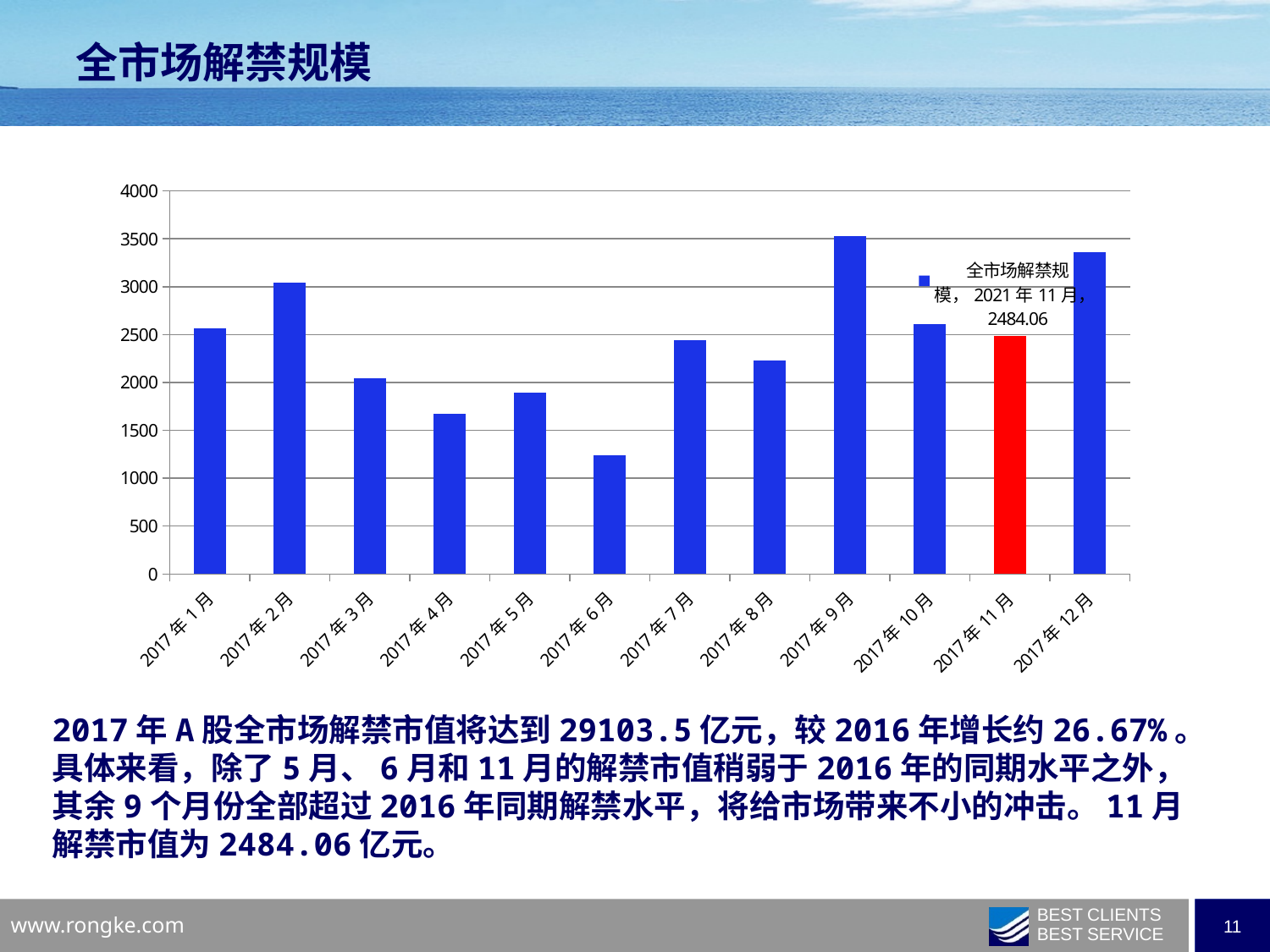
Which is larger, the value for 2017年9月 or 2017年10月? 2017年9月 What kind of chart is shown? bar chart Which is larger, the value for 2017年2月 or 2017年1月? 2017年2月 Which month's bar is coloured red? 2017年11月 Is the value for 2017年12月 greater or less than 3000? greater Is the value for 2017年5月 greater or less than 2000? less How many months are shown on the x axis? 12 What is the value for 2017年11月? 2484.06 Which month has the highest bar? 2017年9月 Which month has the lowest bar? 2017年6月 Is the value for 2017年4月 greater or less than 1500? greater